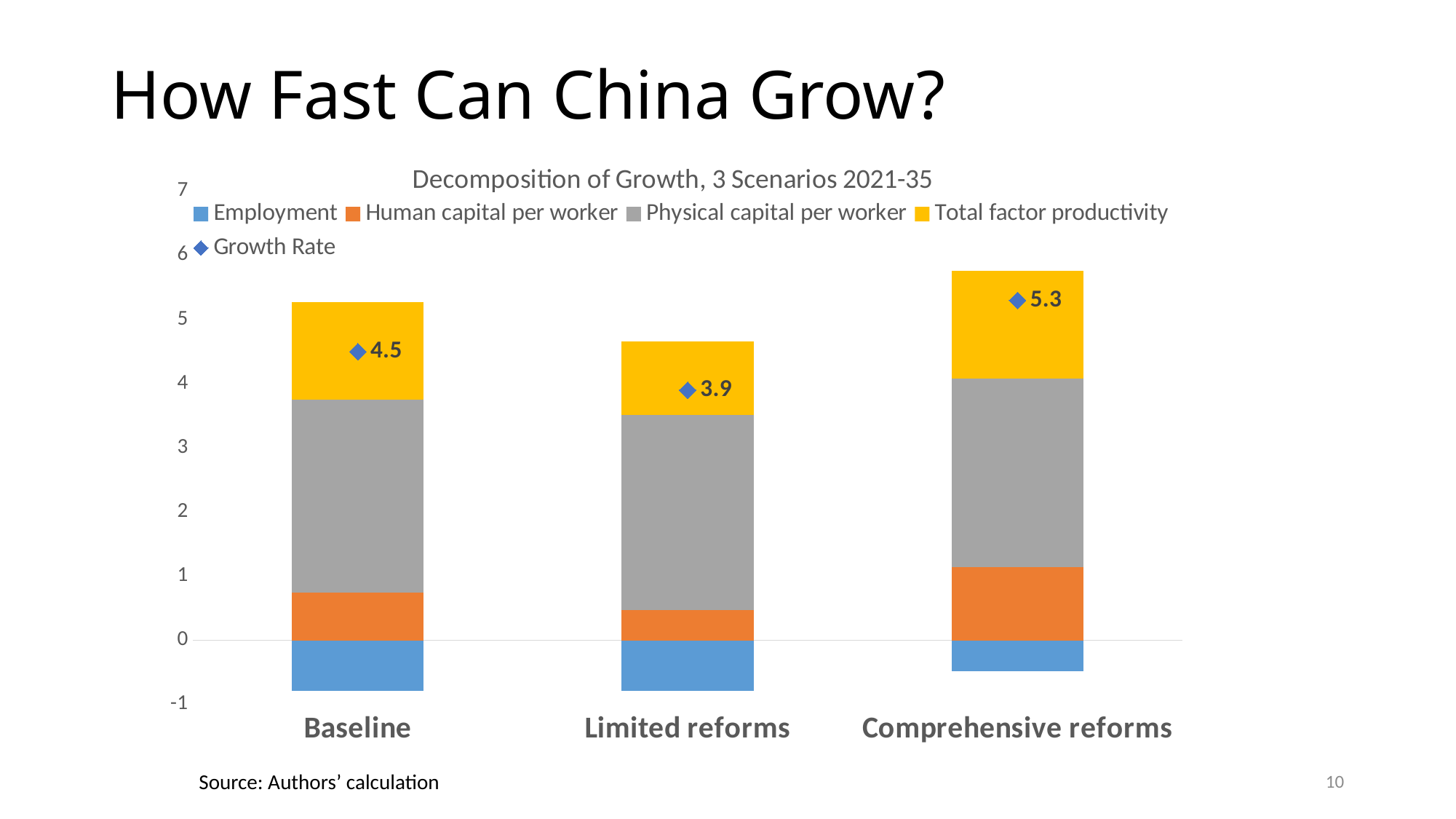
How many scenarios are shown on the x axis? 3 What is the difference between the Growth Rate for Comprehensive reforms and for Limited reforms? 1.4 Is the top of the stacked bar for Comprehensive reforms greater or less than 5? greater What is the title of the chart? Decomposition of Growth, 3 Scenarios 2021-35 Which scenario has the highest Growth Rate? Comprehensive reforms Which scenario has the lowest Growth Rate? Limited reforms Which has a larger Growth Rate, Baseline or Limited reforms? Baseline Is the Employment value for Baseline greater or less than 0? less What is the Growth Rate value shown for Comprehensive reforms? 5.3 How many series does the legend list? 5 What is the Growth Rate value shown for Limited reforms? 3.9 What is the Growth Rate value shown for the Baseline scenario? 4.5